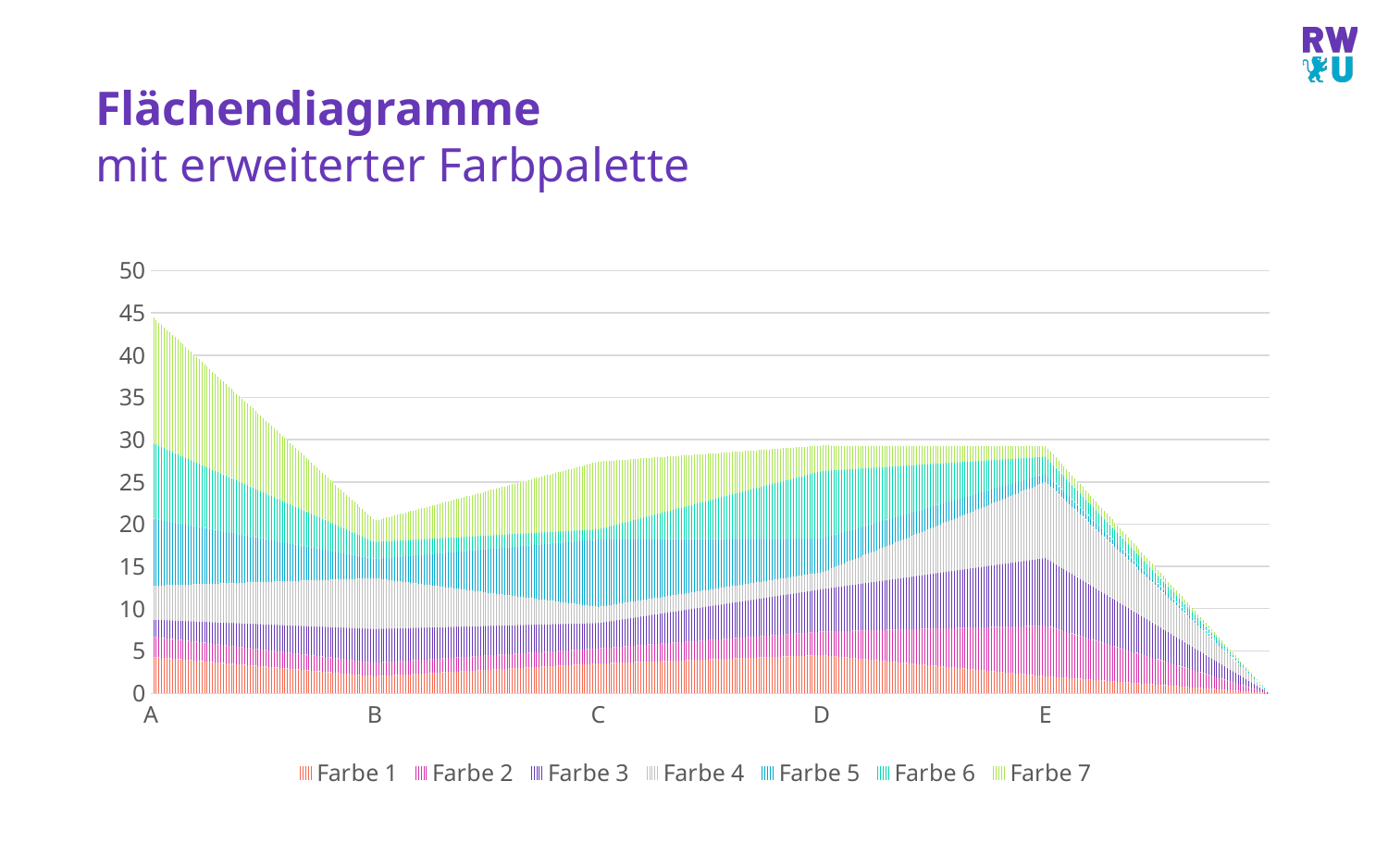
Does the stacked total rise or fall from category A to category B? fall Is the stacked total at category A greater or less than 40? greater Is the stacked total at category B greater or less than 25? less What is the name of the last series listed in the legend? Farbe 7 How many labeled categories are shown on the x axis? 5 How many series does the legend list? 7 Is the stacked total at category D greater or less than 25? greater Which has the larger stacked total, category A or category B? A What kind of chart is shown on the slide? Stacked area chart Among the labeled categories A to E, at which category is the stacked total lowest? B Among the labeled categories A to E, at which category is the stacked total highest? A What is the title of the slide containing the chart? Flächendiagramme mit erweiterter Farbpalette